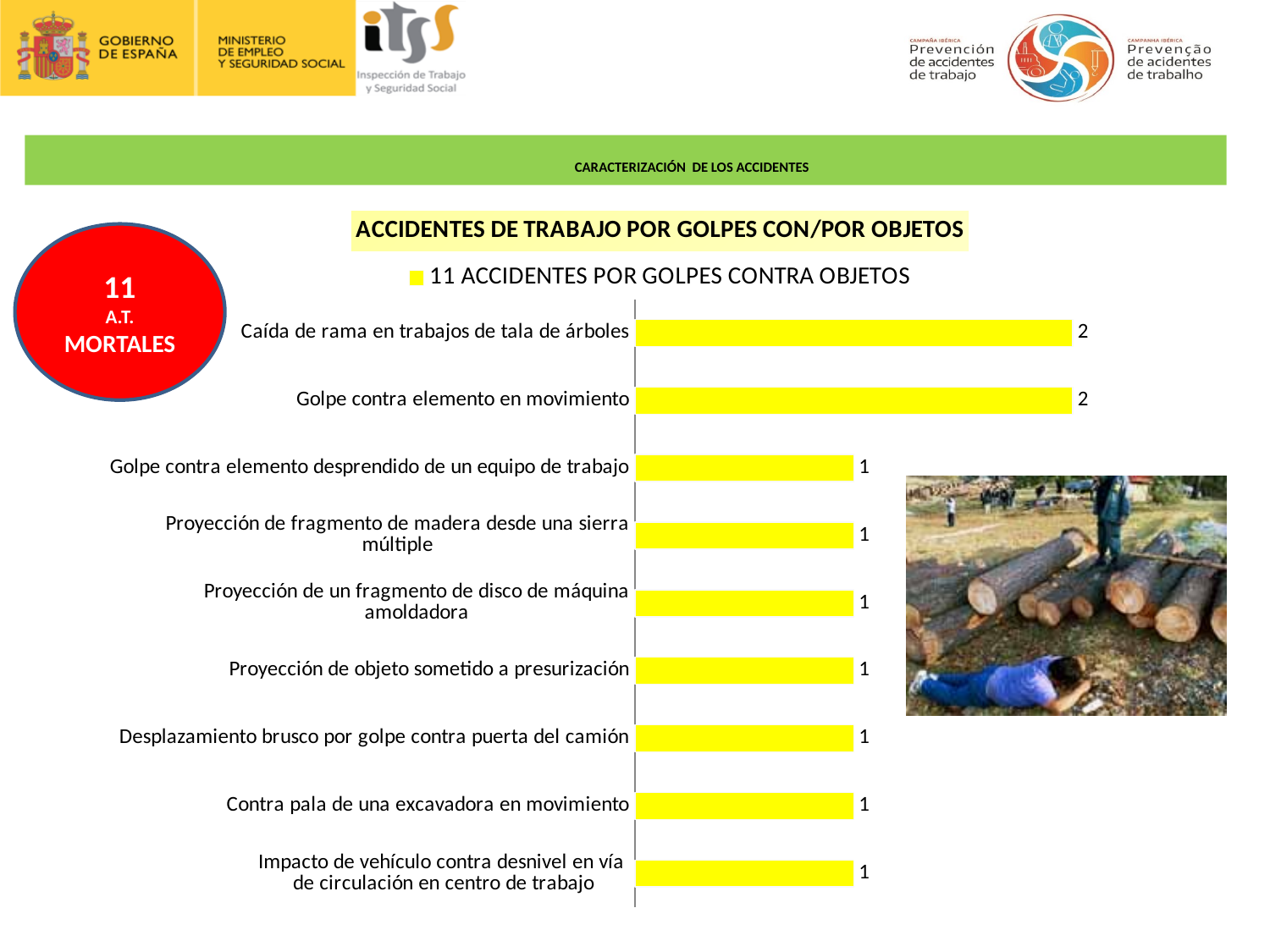
What is the total of all the values plotted in the chart? 11 How many series does the chart legend list? 1 What is the legend entry of the chart? 11 ACCIDENTES POR GOLPES CONTRA OBJETOS Which is larger, the value for "Caída de rama en trabajos de tala de árboles" or the value for "Impacto de vehículo contra desnivel en vía de circulación en centro de trabajo"? Caída de rama en trabajos de tala de árboles What value is shown for "Proyección de objeto sometido a presurización"? 1 What value is shown for "Caída de rama en trabajos de tala de árboles"? 2 What kind of chart is shown on the slide? bar chart What colour are the bars in the chart? yellow What value is shown for "Golpe contra elemento en movimiento"? 2 What is the difference between the values for "Golpe contra elemento en movimiento" and "Desplazamiento brusco por golpe contra puerta del camión"? 1 What value is shown for "Contra pala de una excavadora en movimiento"? 1 How many categories are plotted in the chart? 9